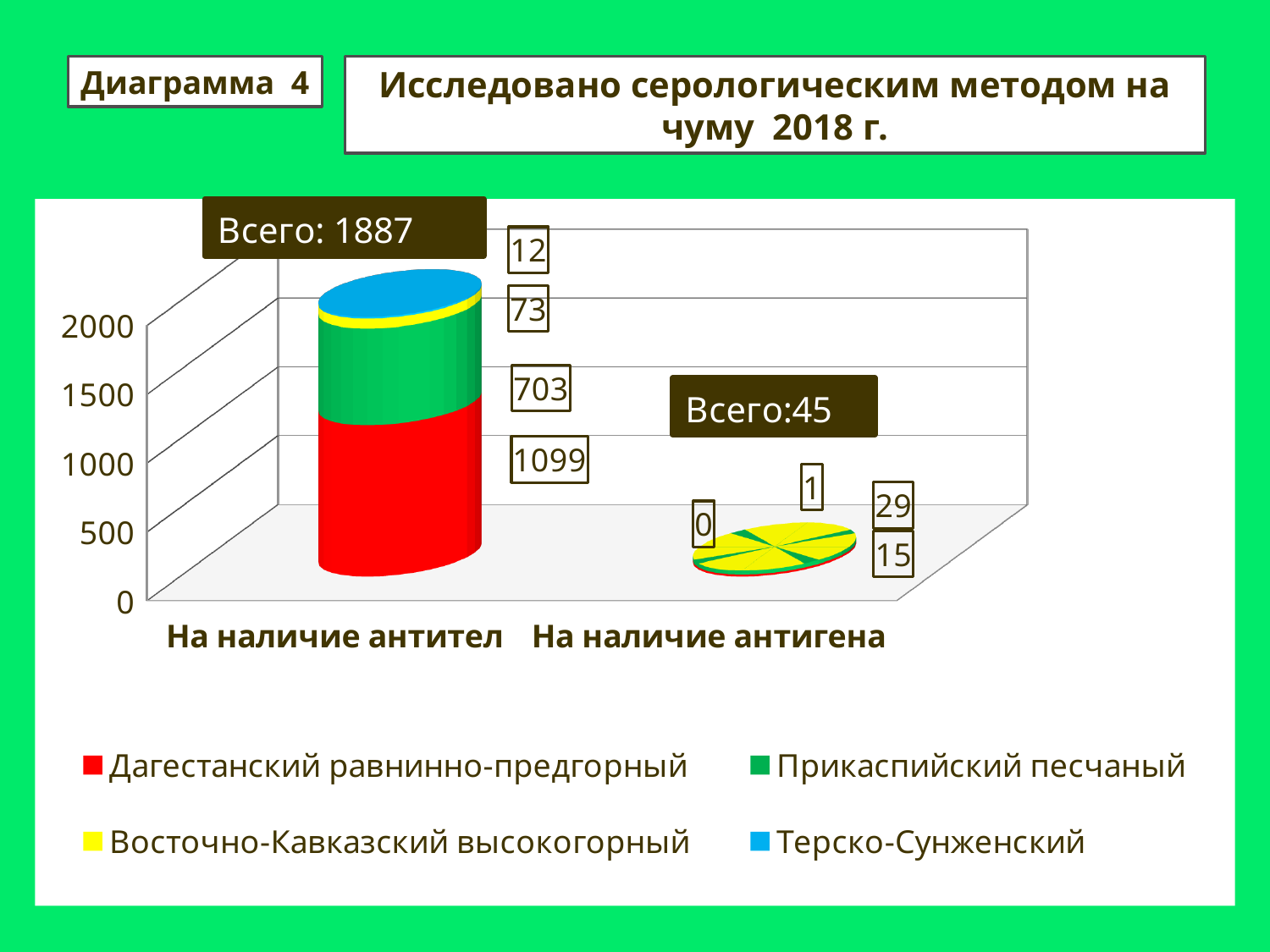
What is the total of the На наличие антител stacked bar? 1887 What kind of chart is shown on the slide? Bar chart Which series has the smallest value in the На наличие антител bar? Терско-Сунженский What is the difference between the Дагестанский равнинно-предгорный and Прикаспийский песчаный values in the На наличие антител bar? 396 How many series does the legend list? 4 What is the value for Дагестанский равнинно-предгорный in the На наличие антител bar? 1099 What is the total of the На наличие антигена stacked bar? 45 What is the value for Терско-Сунженский in the На наличие антител bar? 12 Which series has the largest value in the На наличие антител bar? Дагестанский равнинно-предгорный What is the value for Прикаспийский песчаный in the На наличие антител bar? 703 Which category has the larger total, На наличие антител or На наличие антигена? На наличие антител What is the value for Восточно-Кавказский высокогорный in the На наличие антител bar? 73